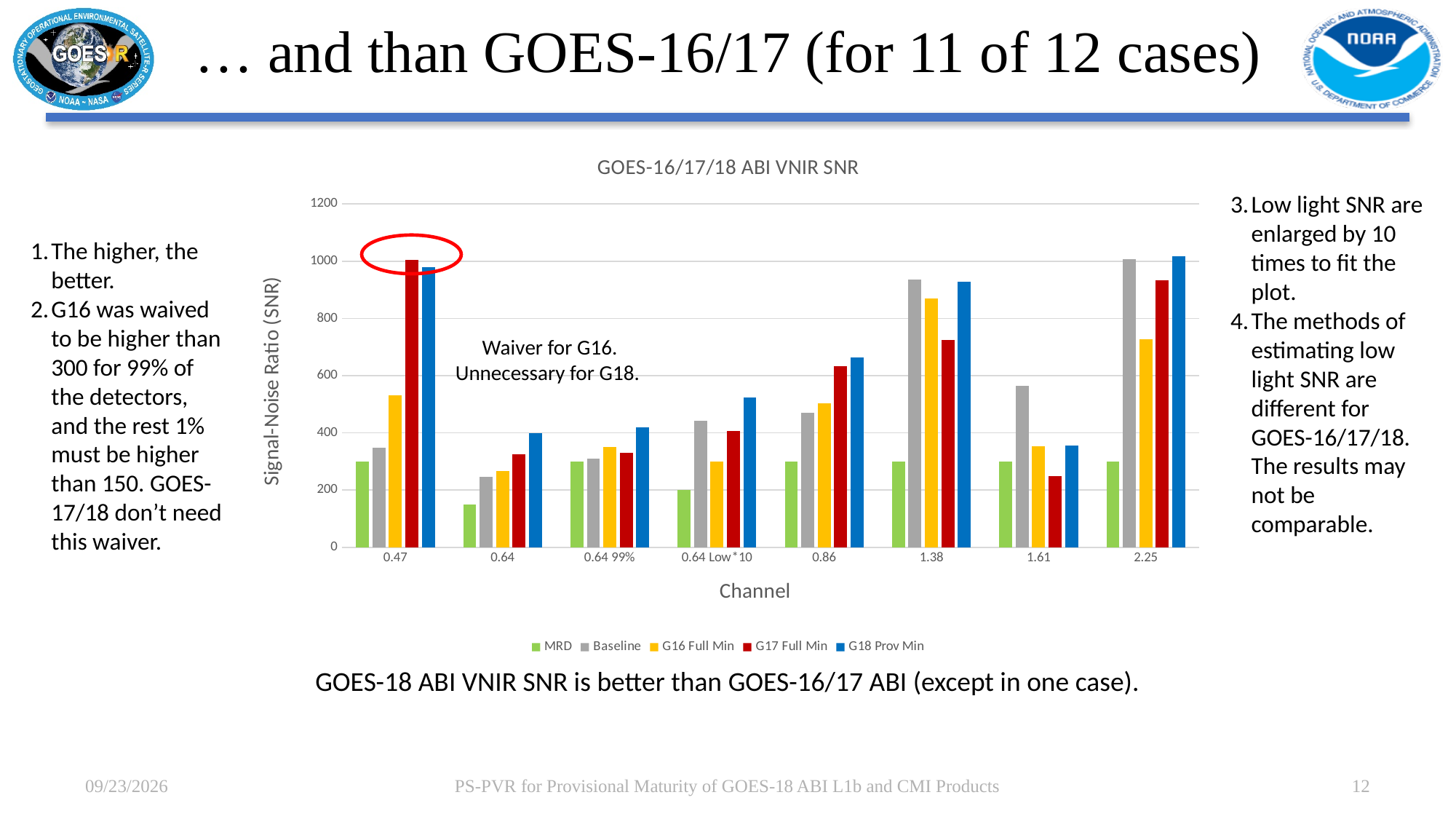
How many series does the legend of the GOES-16/17/18 ABI VNIR SNR chart list? 5 For channel 1.61, which series has the lowest value? G17 Full Min How many channel categories are shown on the x axis of the chart? 8 What is the title of the y axis of the chart? Signal-Noise Ratio (SNR) Is the G17 Full Min value for channel 1.61 greater or less than 400? less Is the Baseline value for channel 0.64 Low*10 greater or less than 400? greater For channel 1.61, which is larger: Baseline or G16 Full Min? Baseline Which channel has the lowest MRD value? 0.64 Is the G18 Prov Min value for channel 0.64 Low*10 greater or less than 400? greater For channel 0.47, which is larger: G16 Full Min or G17 Full Min? G17 Full Min What kind of chart is shown on the slide? bar chart